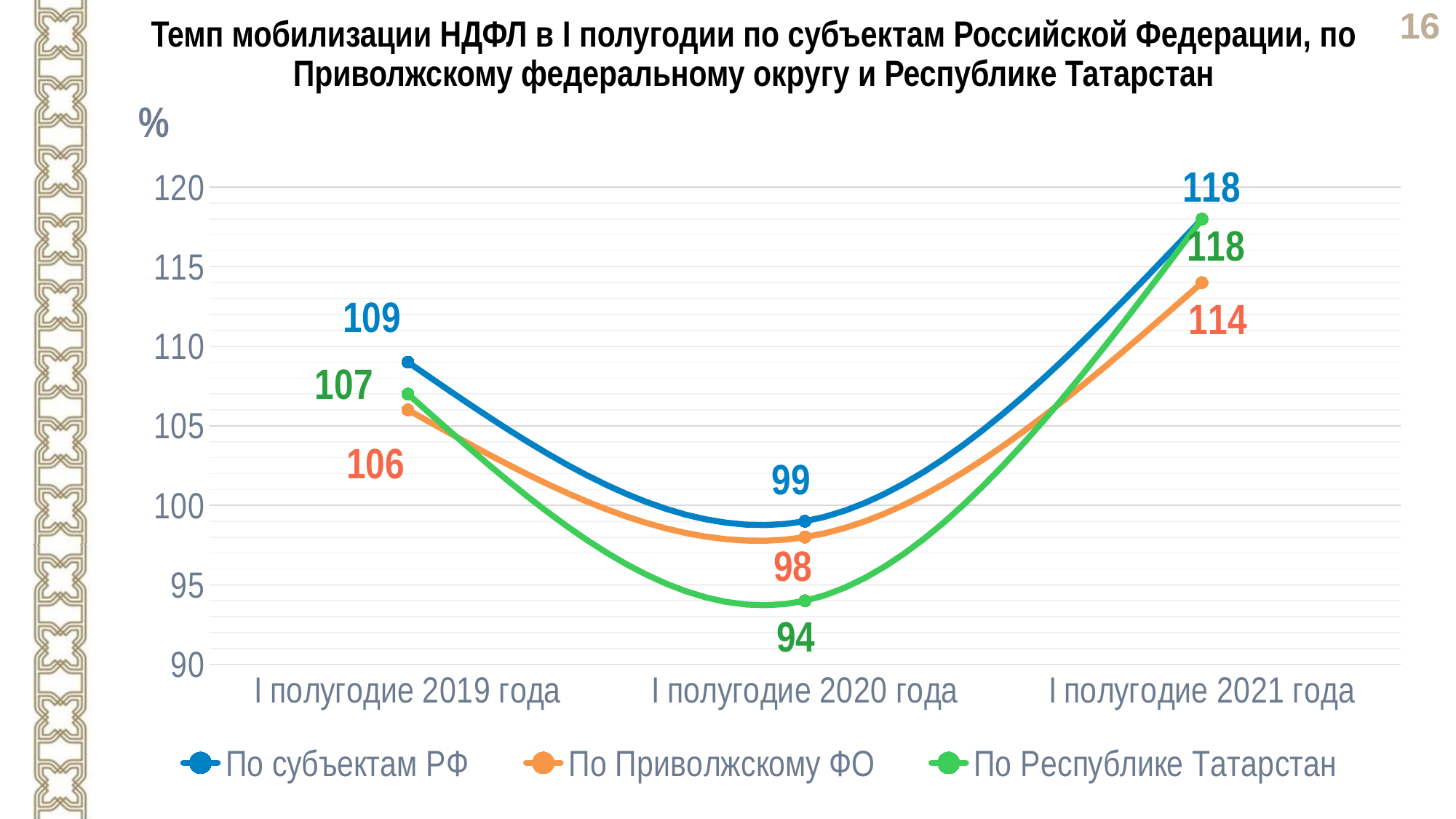
How many series does the legend list? 3 What kind of chart is shown on the slide? line chart What is the value for По субъектам РФ in I полугодие 2019 года? 109 What is the value for По Республике Татарстан in I полугодие 2020 года? 94 In which period is the value for По Республике Татарстан lowest? I полугодие 2020 года Which is larger in I полугодие 2020 года: По субъектам РФ or По Республике Татарстан? По субъектам РФ In which period is the value for По субъектам РФ highest? I полугодие 2021 года Is the value for По Приволжскому ФО in I полугодие 2020 года greater or less than 100? less How does the value for По субъектам РФ change from I полугодие 2020 года to I полугодие 2021 года? rises What is the difference between the По Республике Татарстан values in I полугодие 2021 года and I полугодие 2020 года? 24 What is the value for По Приволжскому ФО in I полугодие 2019 года? 106 What is the value for По Приволжскому ФО in I полугодие 2021 года? 114